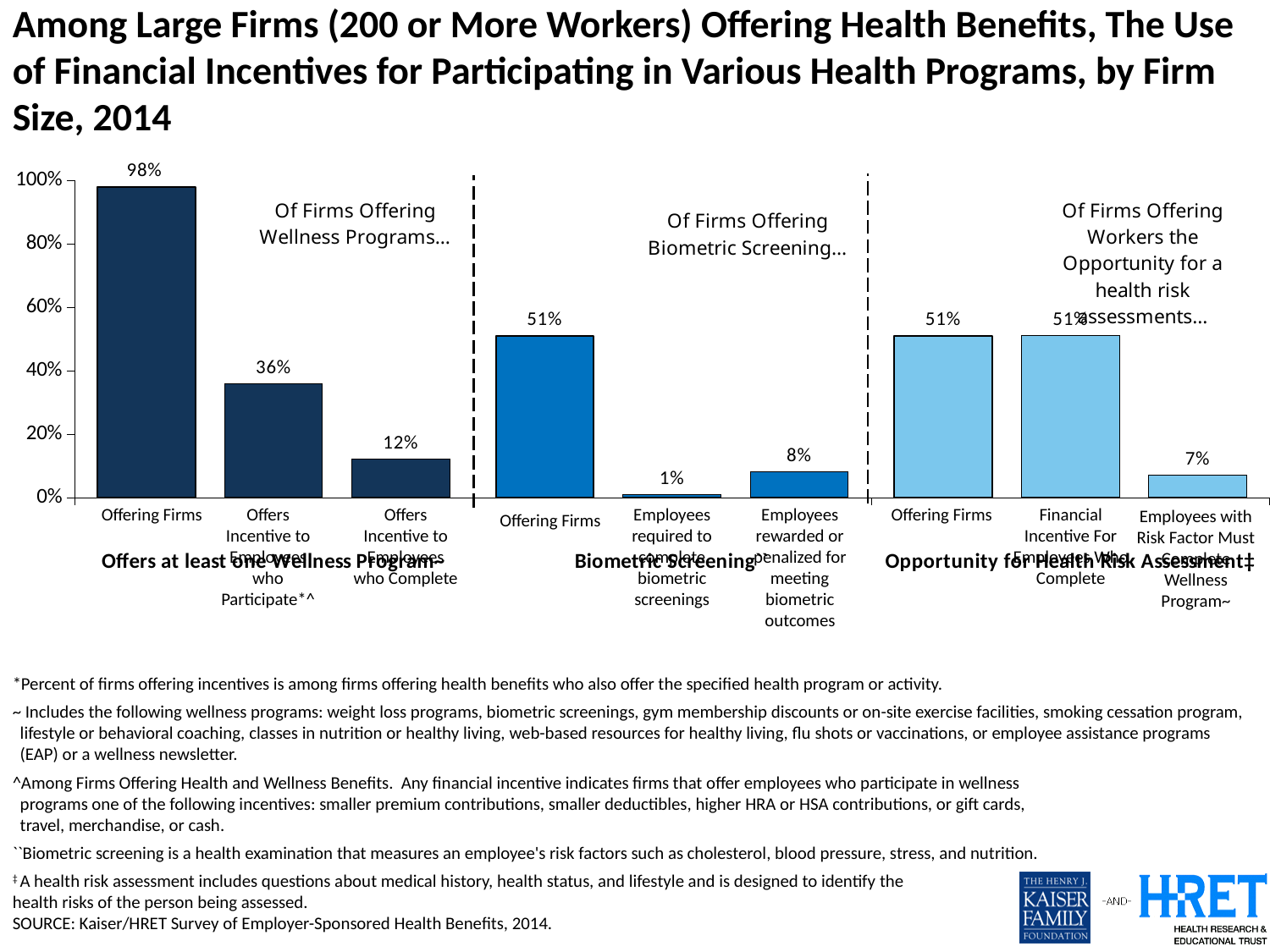
Among firms offering biometric screening, what percentage require employees to complete biometric screenings? 1% What type of chart is shown on the slide? Bar chart Which bar in the chart has the lowest value? Employees required to complete biometric screenings How many bars are plotted in the chart? 9 What percentage of large firms offer at least one wellness program (the 'Offering Firms' bar in the wellness section)? 98% Among firms offering wellness programs, what percentage offer an incentive to employees who complete? 12% What is the difference between the share of firms offering an incentive to employees who participate in wellness programs and the share offering an incentive to employees who complete? 24 percentage points Among firms offering biometric screening, what percentage reward or penalize employees for meeting biometric outcomes? 8% Which bar in the chart has the highest value? Offering Firms (at least one wellness program) Among firms offering a health risk assessment, what percentage require employees with a risk factor to complete a wellness program? 7% Which is larger: the share of firms rewarding or penalizing employees for biometric outcomes, or the share requiring employees with a risk factor to complete a wellness program? Rewarding or penalizing for biometric outcomes (8%) Among firms offering wellness programs, what percentage offer an incentive to employees who participate? 36%